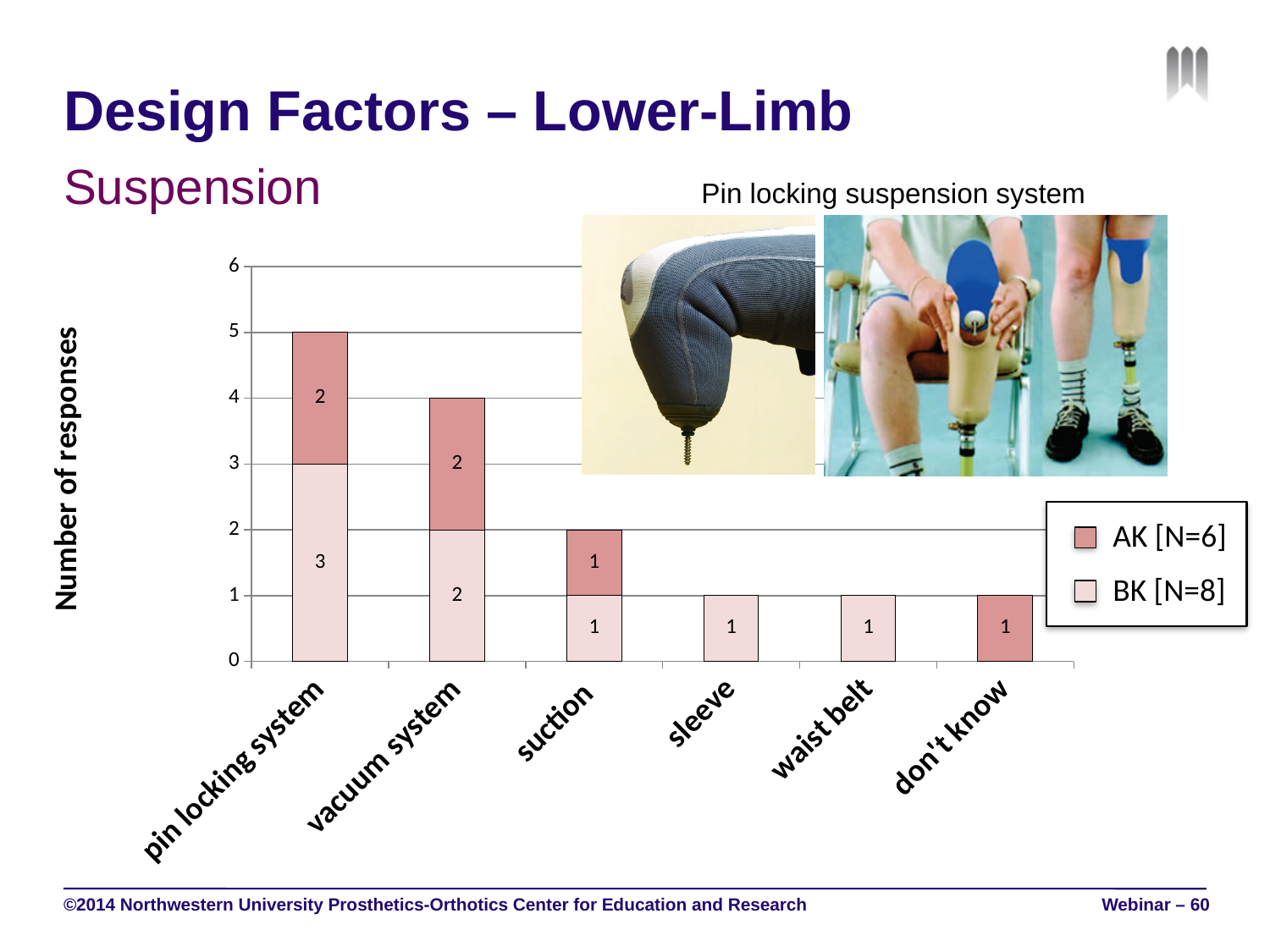
What is the AK [N=6] value for don't know? 1 What is the BK [N=8] value for pin locking system? 3 What is the total height of the stacked bar for pin locking system? 5 What is the difference between the BK [N=8] values for pin locking system and vacuum system? 1 What is the label of the y axis? Number of responses How many categories are shown on the x axis? 6 Which is larger, the total for suction or the total for sleeve? suction Which category has the highest total number of responses? pin locking system How many series does the legend list? 2 What is the AK [N=6] value for vacuum system? 2 What is the total height of the stacked bar for vacuum system? 4 What kind of chart is shown on the slide? stacked bar chart